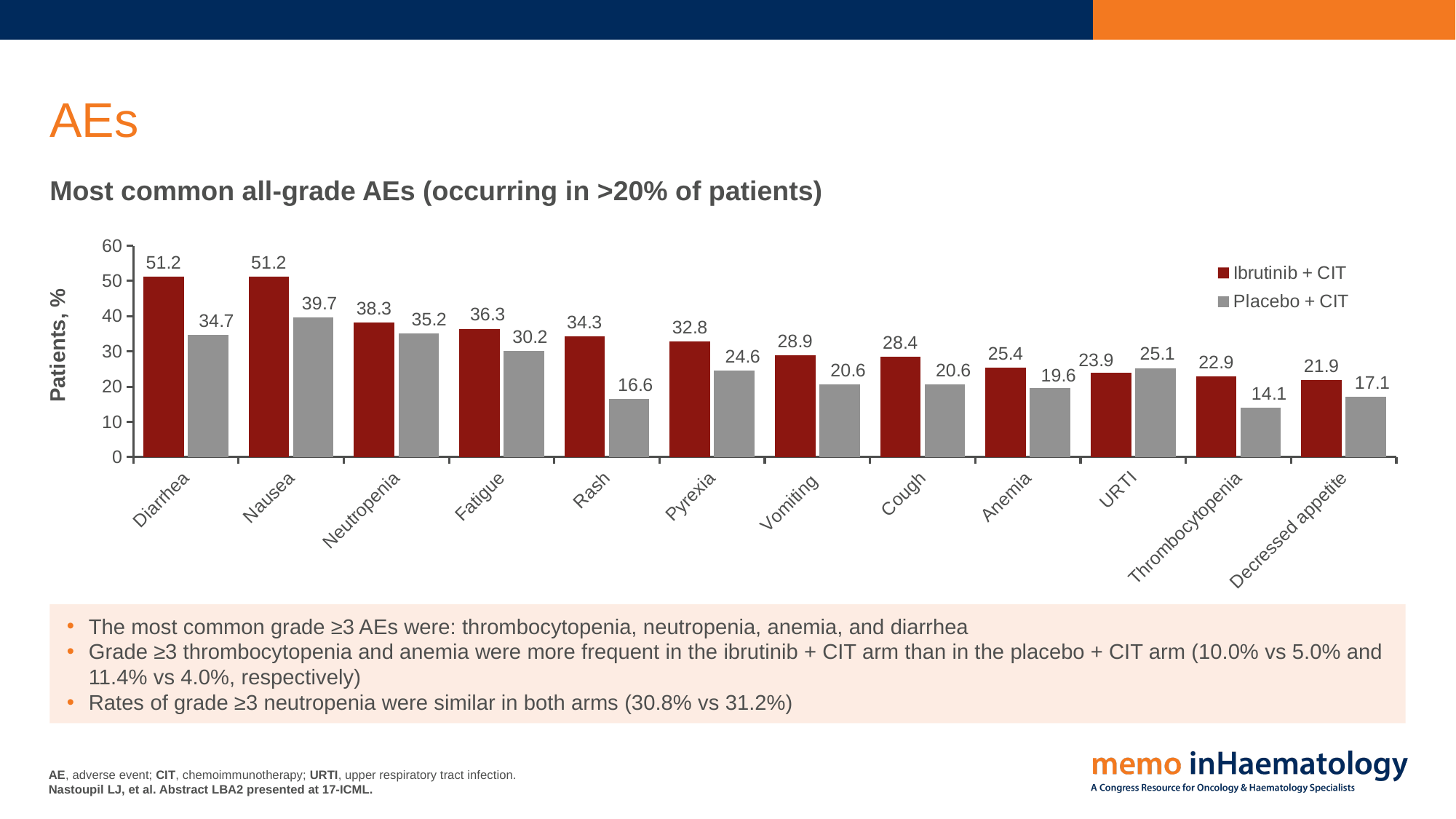
What kind of chart is shown on the slide? Bar chart What is the value for Placebo + CIT for Nausea? 39.7 Which adverse event has the lowest value for Placebo + CIT? Thrombocytopenia What is the value for Placebo + CIT for Thrombocytopenia? 14.1 Which adverse event has the highest value for Placebo + CIT? Nausea What is the difference between the Ibrutinib + CIT and Placebo + CIT values for Diarrhea? 16.5 How many adverse event categories are shown on the x axis? 12 For URTI, which series has the larger value, Ibrutinib + CIT or Placebo + CIT? Placebo + CIT What is the value for Ibrutinib + CIT for Rash? 34.3 What is the difference between the Ibrutinib + CIT and Placebo + CIT values for Rash? 17.7 Which adverse event has the lowest value for Ibrutinib + CIT? Decressed appetite How many series does the legend list? 2